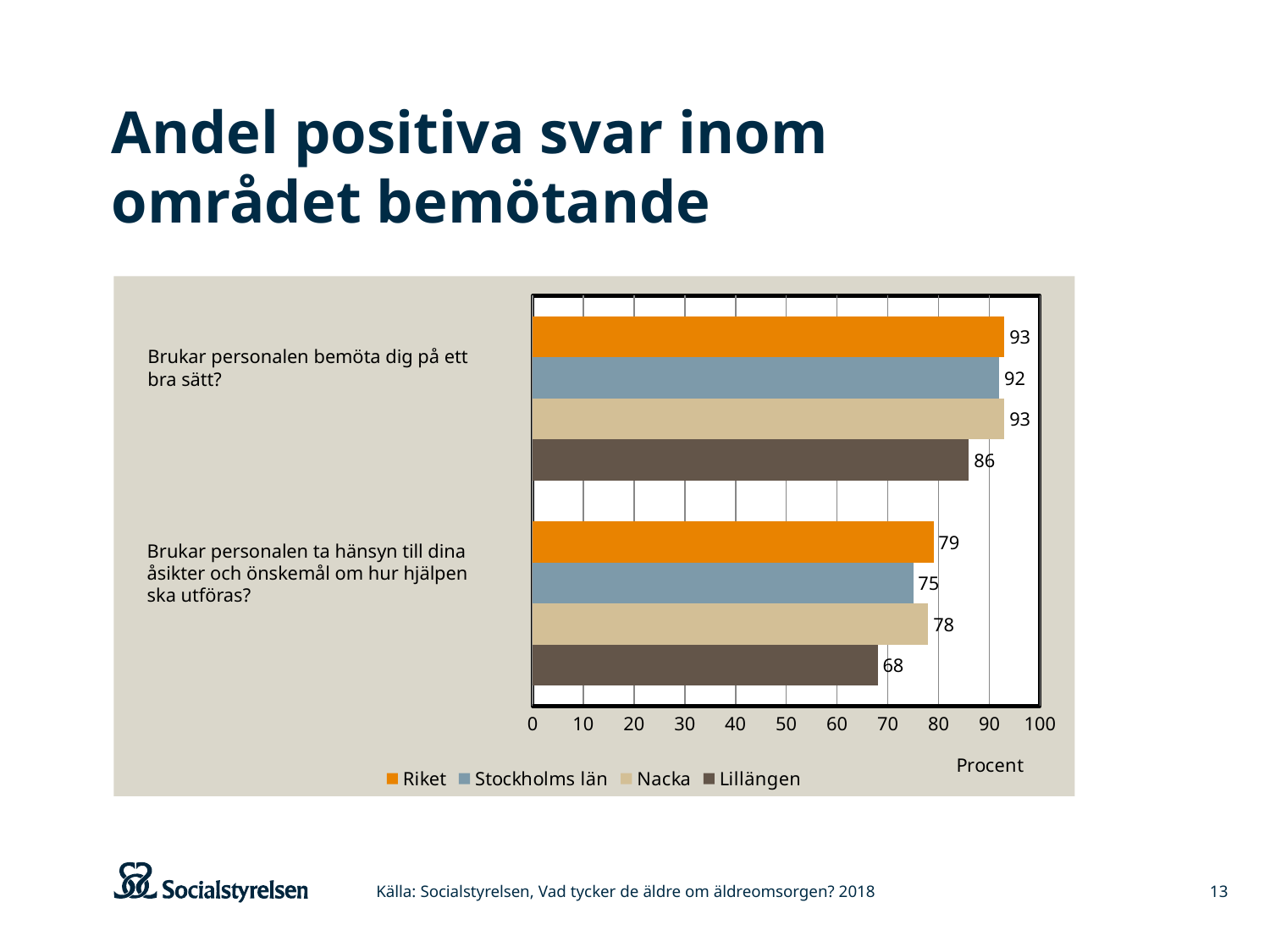
What is the difference between the Nacka and Lillängen values for the question 'Brukar personalen bemöta dig på ett bra sätt?'? 7 What is the value for Nacka for the question 'Brukar personalen bemöta dig på ett bra sätt?'? 93 What is the difference between the Riket and Lillängen values for the question 'Brukar personalen ta hänsyn till dina åsikter och önskemål om hur hjälpen ska utföras?'? 11 What is the value for Lillängen for the question 'Brukar personalen ta hänsyn till dina åsikter och önskemål om hur hjälpen ska utföras?'? 68 What is the value for Riket for the question 'Brukar personalen bemöta dig på ett bra sätt?'? 93 Which series has the highest value for the question 'Brukar personalen ta hänsyn till dina åsikter och önskemål om hur hjälpen ska utföras?'? Riket What is the label on the horizontal axis of the chart? Procent What is the value for Stockholms län for the question 'Brukar personalen ta hänsyn till dina åsikter och önskemål om hur hjälpen ska utföras?'? 75 What kind of chart is shown on the slide? Bar chart Which series has the lowest value for the question 'Brukar personalen bemöta dig på ett bra sätt?'? Lillängen How many series does the legend list? 4 Which is larger: the Nacka value or the Stockholms län value for the question 'Brukar personalen ta hänsyn till dina åsikter och önskemål om hur hjälpen ska utföras?'? Nacka